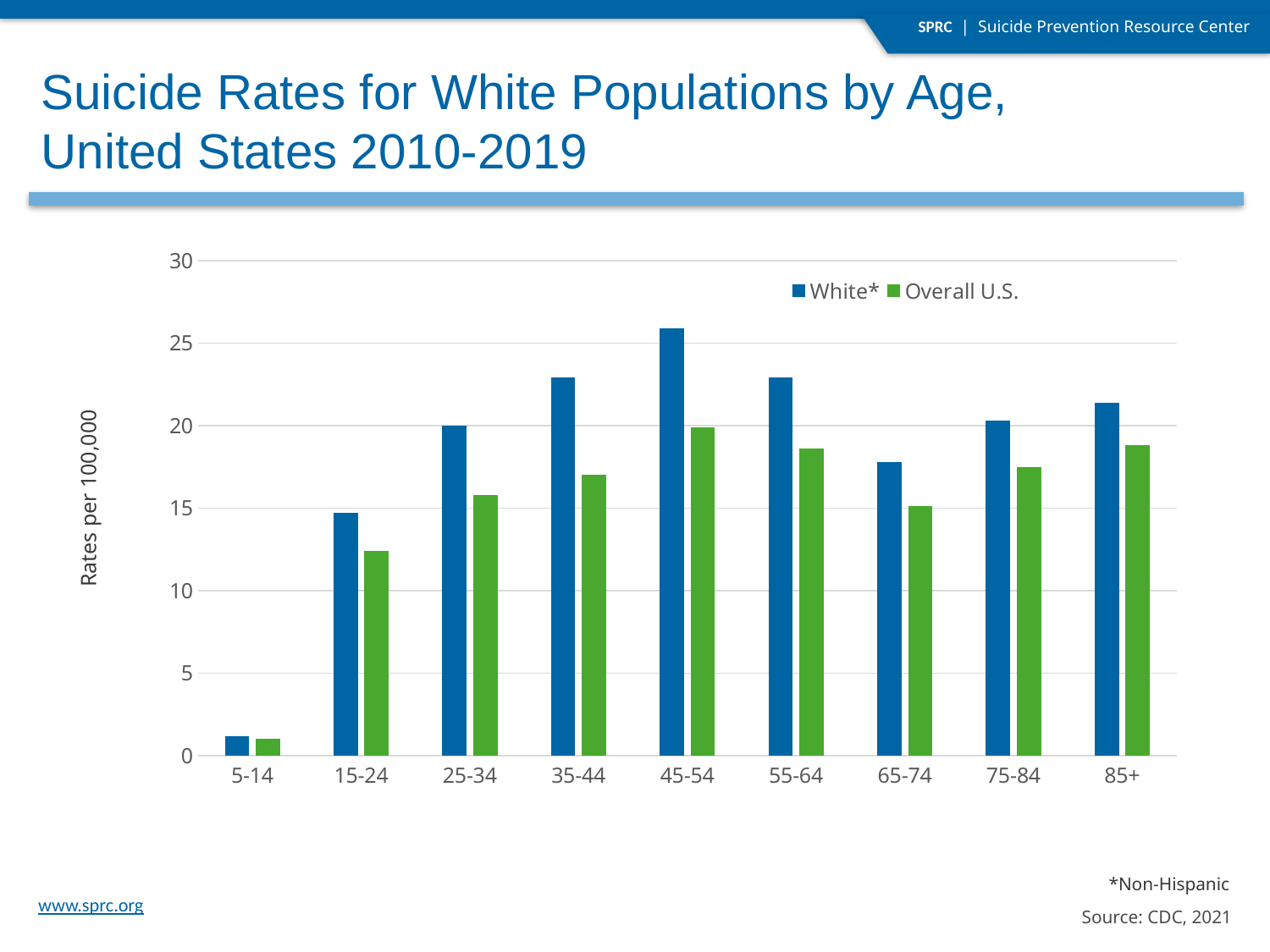
Which age group has the highest suicide rate for the Overall U.S. series? 45-54 How many age groups are shown on the x axis? 9 How many series does the legend list? 2 What kind of chart is shown on the slide? Bar chart Is the White* value for the 45-54 age group greater or less than 25? greater Is the Overall U.S. value for the 25-34 age group greater or less than 20? less Do the White* values rise or fall from the 5-14 age group to the 45-54 age group? Rise What is the label on the y axis? Rates per 100,000 For the 15-24 age group, which series has the larger value, White* or Overall U.S.? White* Which age group has the highest suicide rate for the White* series? 45-54 Which age group has the lowest suicide rate for the White* series? 5-14